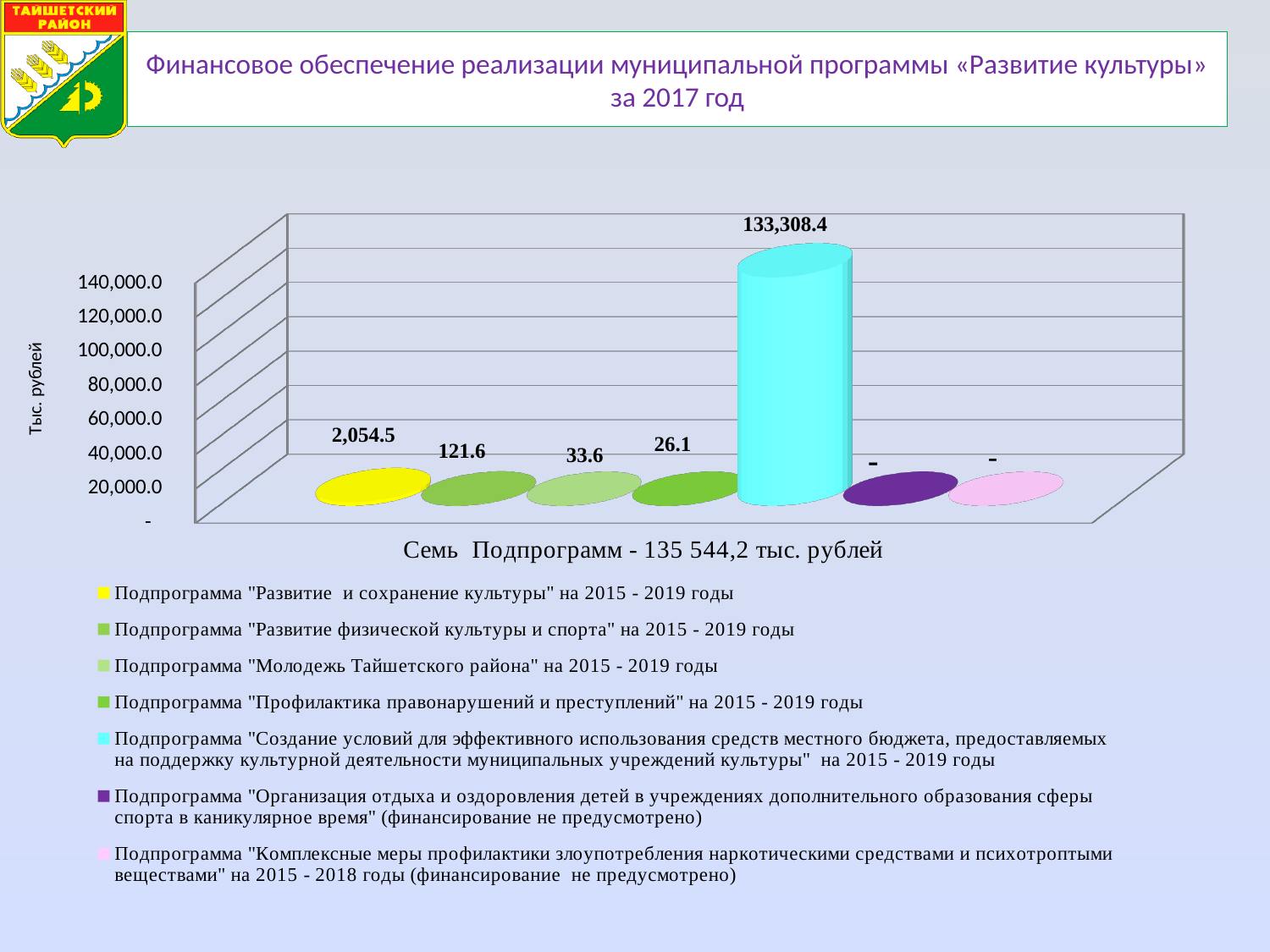
What is the difference between the value for "Молодежь Тайшетского района" and the value for "Профилактика правонарушений и преступлений"? 7.5 What kind of chart is shown on the slide? Bar chart What is the difference between the value for "Развитие и сохранение культуры" and the value for "Развитие физической культуры и спорта"? 1,932.9 Which is larger: the value for "Развитие физической культуры и спорта" or the value for "Молодежь Тайшетского района"? Развитие физической культуры и спорта Among the subprograms with a numeric value shown, which has the lowest value? Подпрограмма "Профилактика правонарушений и преступлений" на 2015 - 2019 годы Is the value for "Создание условий для эффективного использования средств местного бюджета..." greater or less than 120,000.0? greater What is the value shown for the subprogram "Развитие и сохранение культуры" на 2015 - 2019 годы? 2,054.5 What is the value shown for the subprogram "Создание условий для эффективного использования средств местного бюджета..."? 133,308.4 Which subprogram has the highest value on the chart? Подпрограмма "Создание условий для эффективного использования средств местного бюджета, предоставляемых на поддержку культурной деятельности муниципальных учреждений культуры" на 2015 - 2019 годы How many series does the legend list? 7 What is the value shown for the subprogram "Профилактика правонарушений и преступлений" на 2015 - 2019 годы? 26.1 What is the value shown for the subprogram "Молодежь Тайшетского района" на 2015 - 2019 годы? 33.6